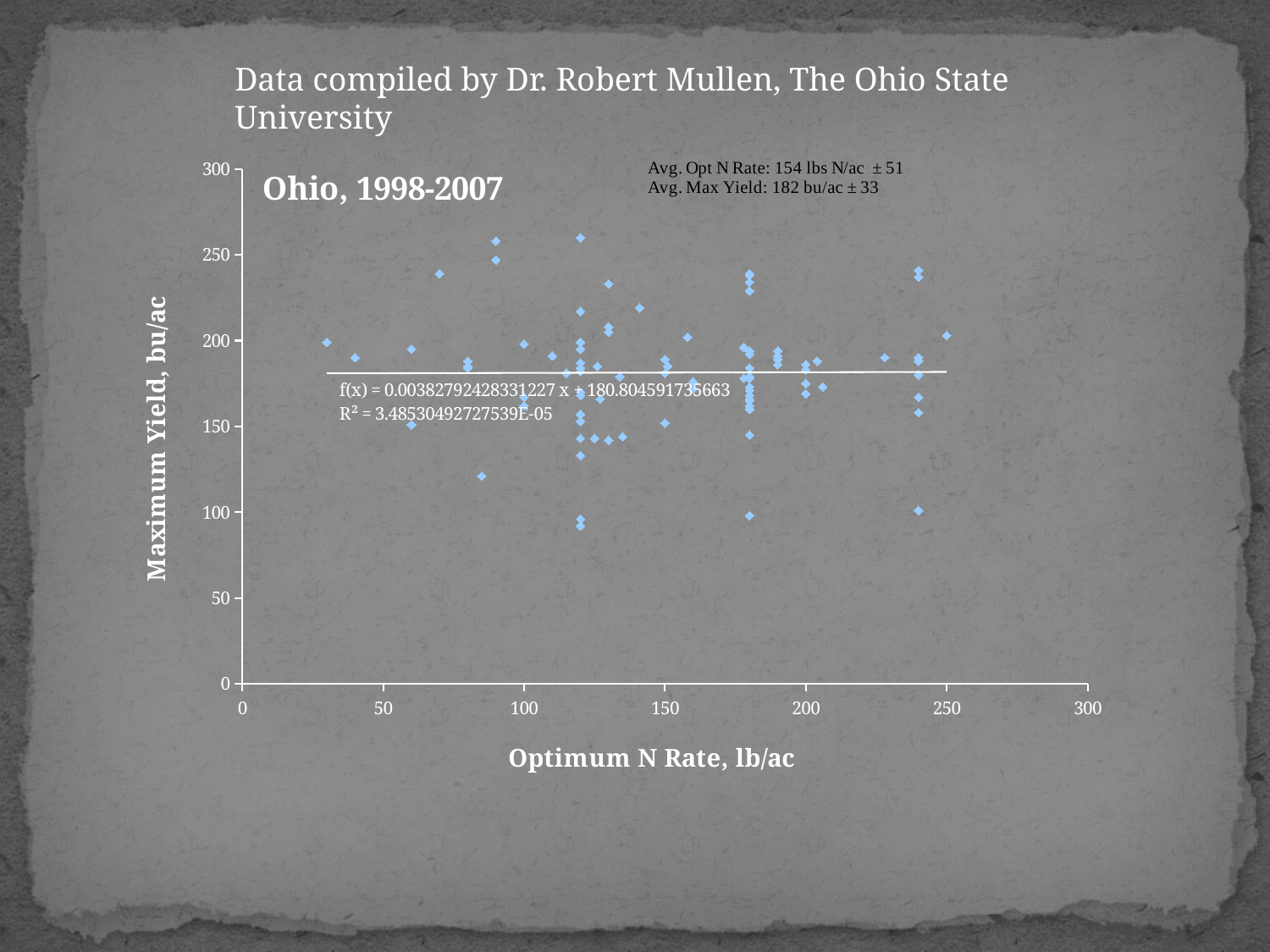
Is the highest point at an Optimum N Rate of 120 lb/ac greater or less than 250 bu/ac? greater What is the label of the y axis? Maximum Yield, bu/ac Is the point at an Optimum N Rate of 85 lb/ac greater or less than 150 bu/ac? less What is the average optimum N rate stated on the chart? 154 lbs N/ac ± 51 Is the lowest point at an Optimum N Rate of 120 lb/ac greater or less than 100 bu/ac? less What is the maximum value shown on the x axis? 300 What is the trendline equation shown on the chart? f(x) = 0.00382792428331227 x + 180.804591735663 What kind of chart is shown on the slide? Scatter plot What is the title of the chart? Ohio, 1998-2007 What is the R² value of the trendline shown on the chart? 3.48530492727539E-05 Does the trendline rise, fall, or stay roughly flat as Optimum N Rate increases? Roughly flat What is the average maximum yield stated on the chart? 182 bu/ac ± 33